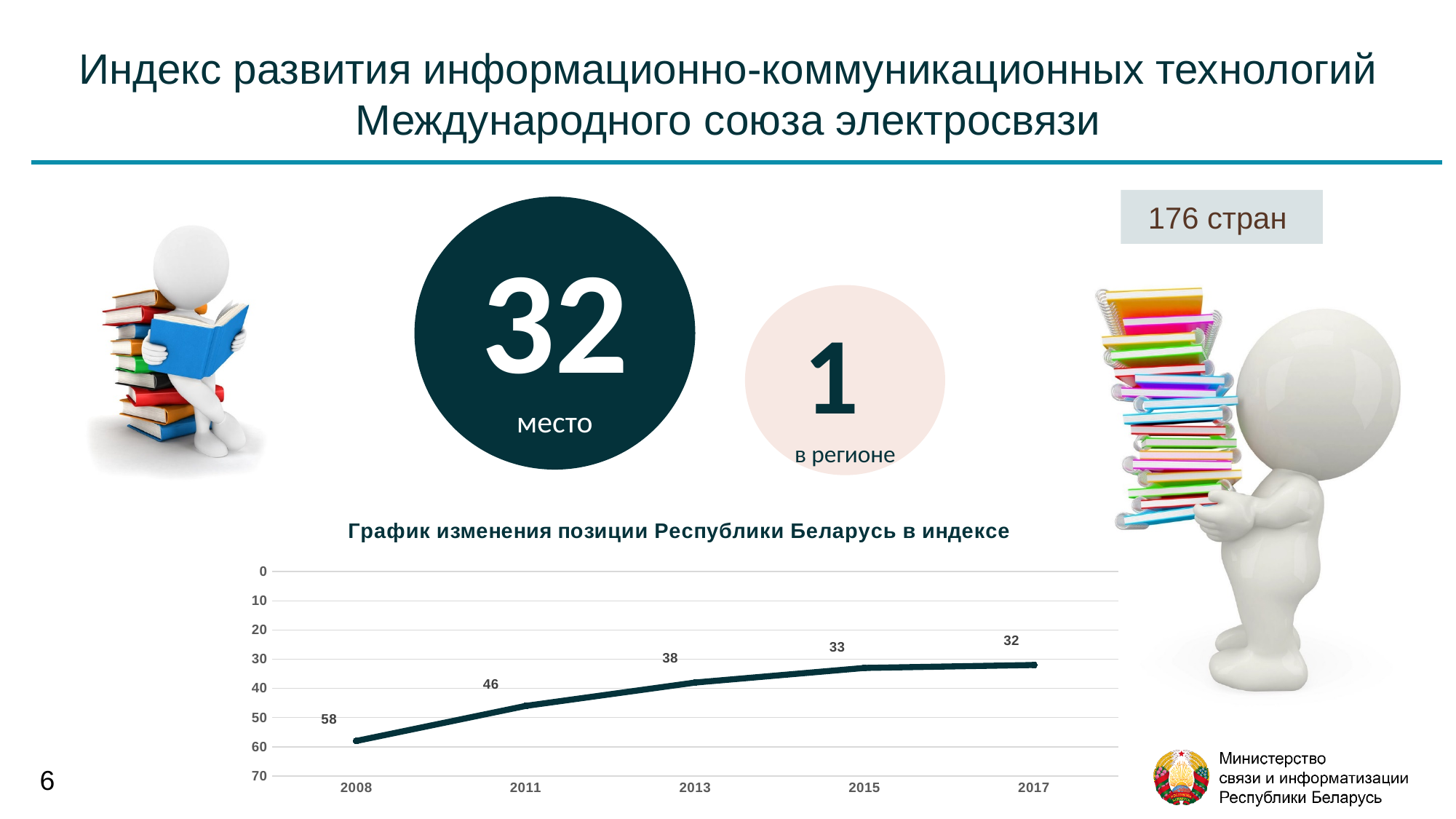
What kind of chart is shown on the slide? line chart What is the value plotted for 2008 in the chart? 58 Which year has the lowest plotted value in the chart? 2017 What is the value plotted for 2013 in the chart? 38 Do the plotted values increase or decrease from 2008 to 2017? decrease How many years are plotted on the x axis of the chart? 5 What is the difference between the values for 2011 and 2013? 8 Which year has the highest plotted value in the chart? 2008 Which is larger, the value for 2015 or the value for 2011? 2011 What is the value plotted for 2017 in the chart? 32 What is the value plotted for 2011 in the chart? 46 What is the difference between the values for 2008 and 2017? 26